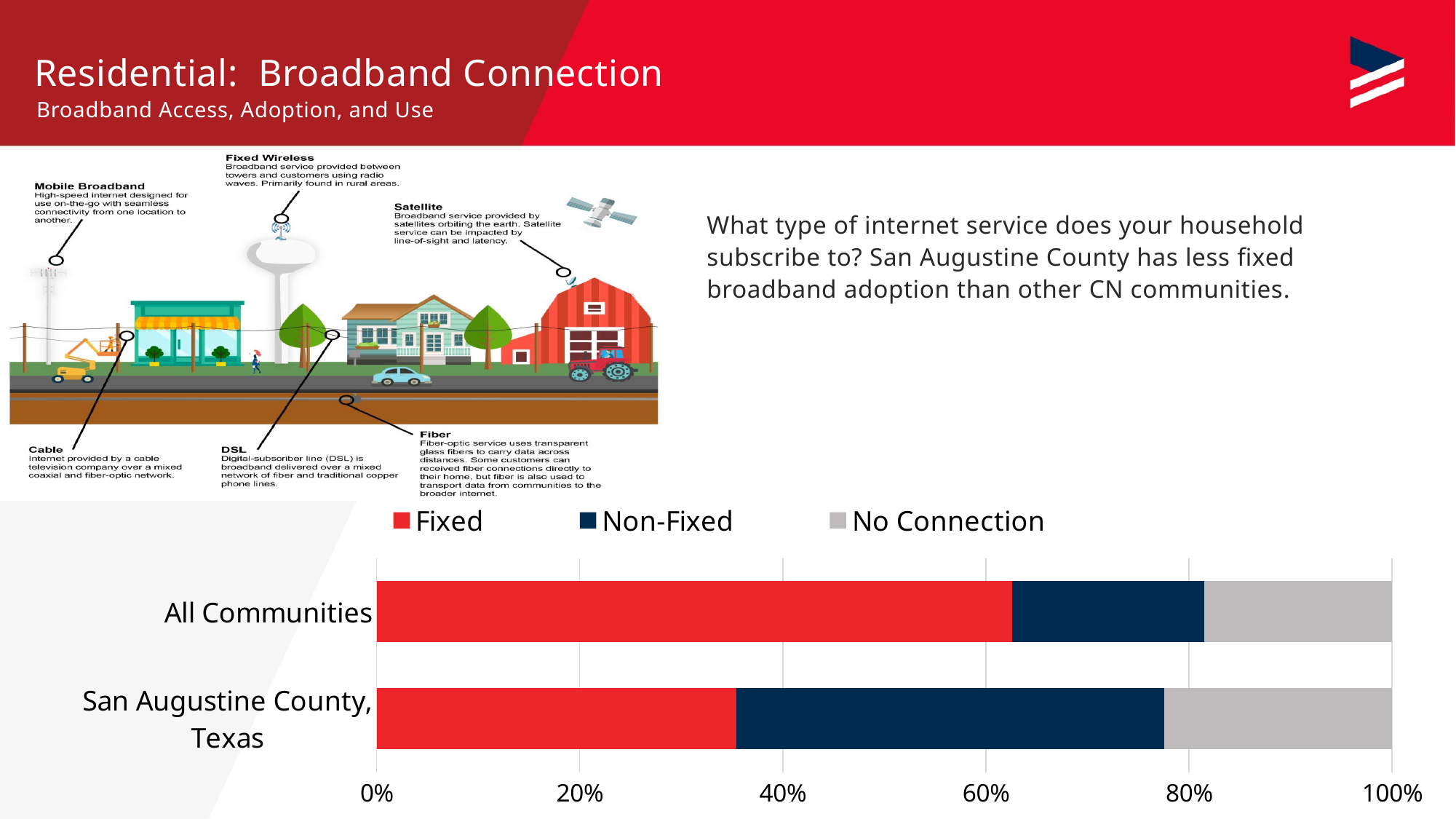
What kind of chart is shown on the slide? Stacked bar chart Which colour represents the Non-Fixed series in the chart? Dark navy blue Which category has the larger Non-Fixed share, All Communities or San Augustine County, Texas? San Augustine County, Texas What are the three series named in the chart legend? Fixed, Non-Fixed, No Connection Which series makes up the largest portion of the San Augustine County, Texas bar? Non-Fixed Is the Fixed value for San Augustine County, Texas greater or less than 40%? less Which series makes up the largest portion of the All Communities bar? Fixed How many categories are plotted on the chart? 2 Which category has the larger Fixed share, All Communities or San Augustine County, Texas? All Communities Is the Non-Fixed value for San Augustine County, Texas greater or less than 20%? greater Is the Fixed value for All Communities greater or less than 40%? greater How many series does the chart legend list? 3